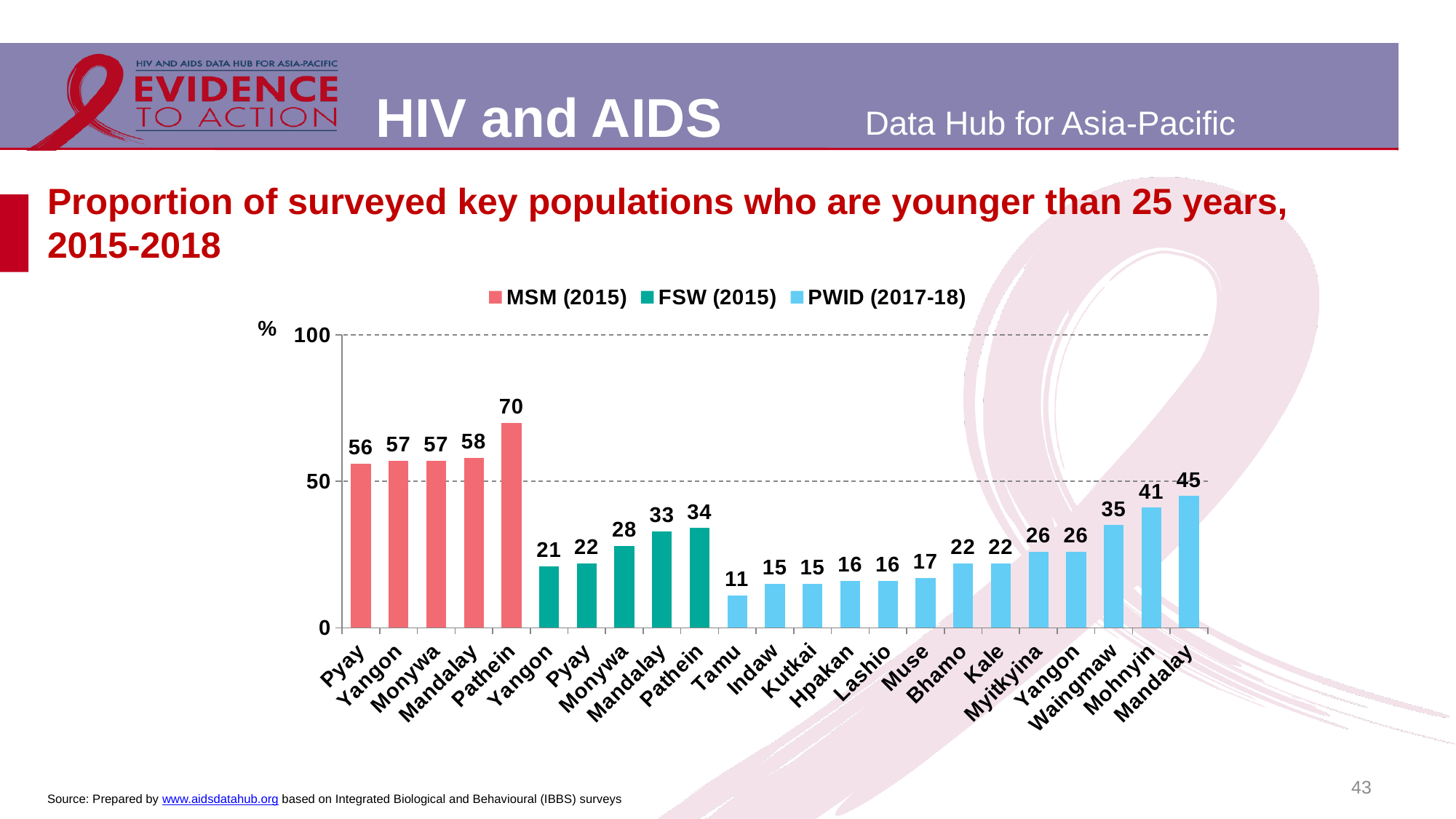
Do the PWID (2017-18) values rise or fall from Tamu to Mandalay along the x axis? Rise How many bars are shown for the PWID (2017-18) series? 13 Which location has the highest value in the MSM (2015) series? Pathein What is the value for Monywa in the FSW (2015) series? 28 Which location has the lowest value in the PWID (2017-18) series? Tamu What kind of chart is shown on the slide? Bar chart What is the value for Pathein in the MSM (2015) series? 70 What is the difference between the MSM (2015) value for Pathein and the MSM (2015) value for Pyay? 14 Which is larger: the FSW (2015) value for Mandalay or the PWID (2017-18) value for Mandalay? PWID (2017-18) value for Mandalay How many series does the legend list? 3 What is the value for Mandalay in the PWID (2017-18) series? 45 What is the difference between the PWID (2017-18) values for Mandalay and Tamu? 34